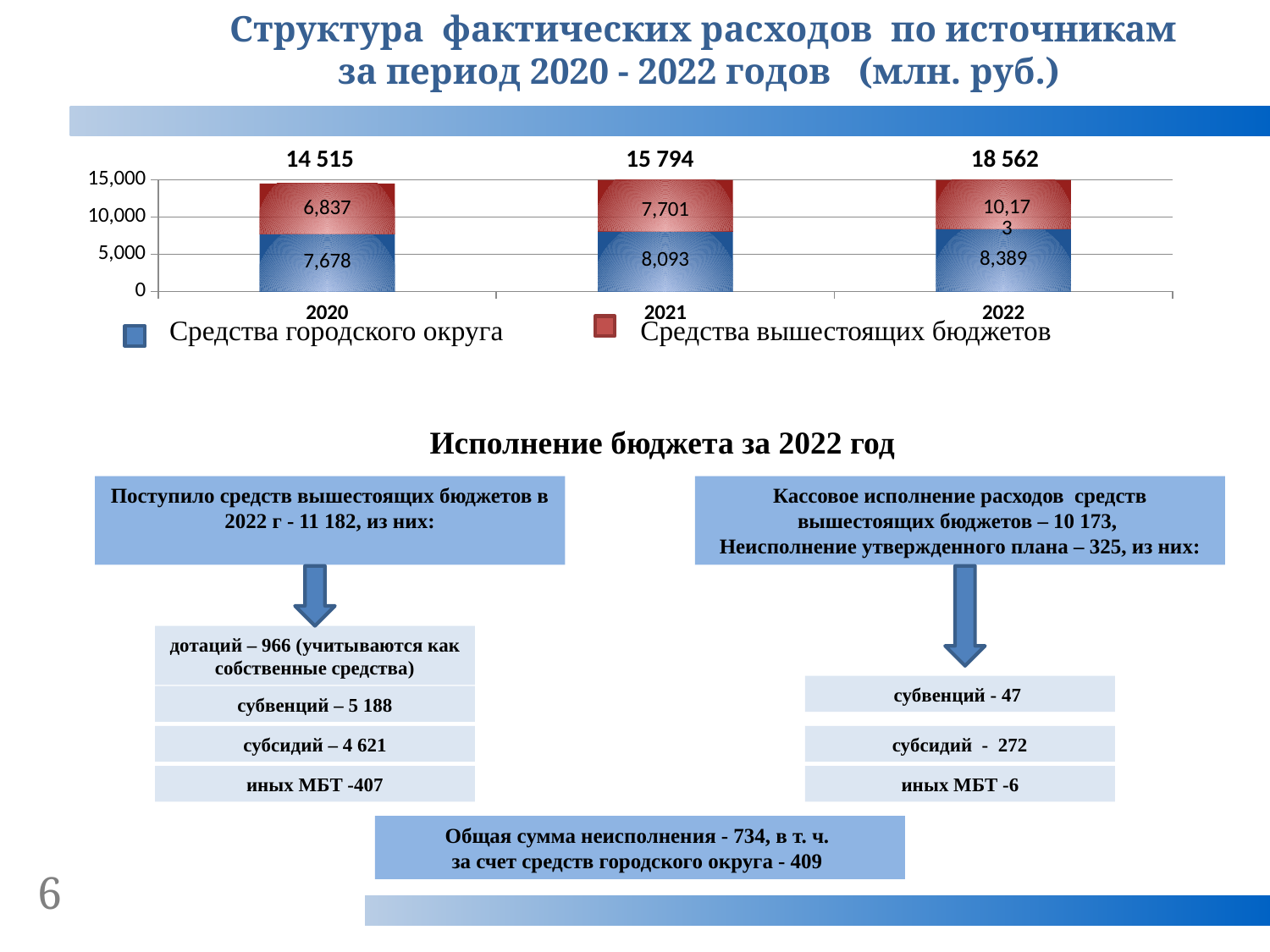
Which year has the lowest value for Средства вышестоящих бюджетов? 2020 Do the total values rise or fall from 2020 to 2022? rise What is the total of the stacked bar for 2022? 18 562 What is the value for Средства вышестоящих бюджетов in 2021? 7,701 What is the difference between the Средства городского округа values for 2022 and 2021? 296 What is the value for Средства городского округа in 2020? 7,678 Which is larger in 2022: Средства городского округа or Средства вышестоящих бюджетов? Средства вышестоящих бюджетов How many years are shown on the x axis of the chart? 3 How many series does the chart legend list? 2 What is the total of the stacked bar for 2020? 14 515 Which year has the highest total expenditure? 2022 What is the value for Средства городского округа in 2022? 8,389